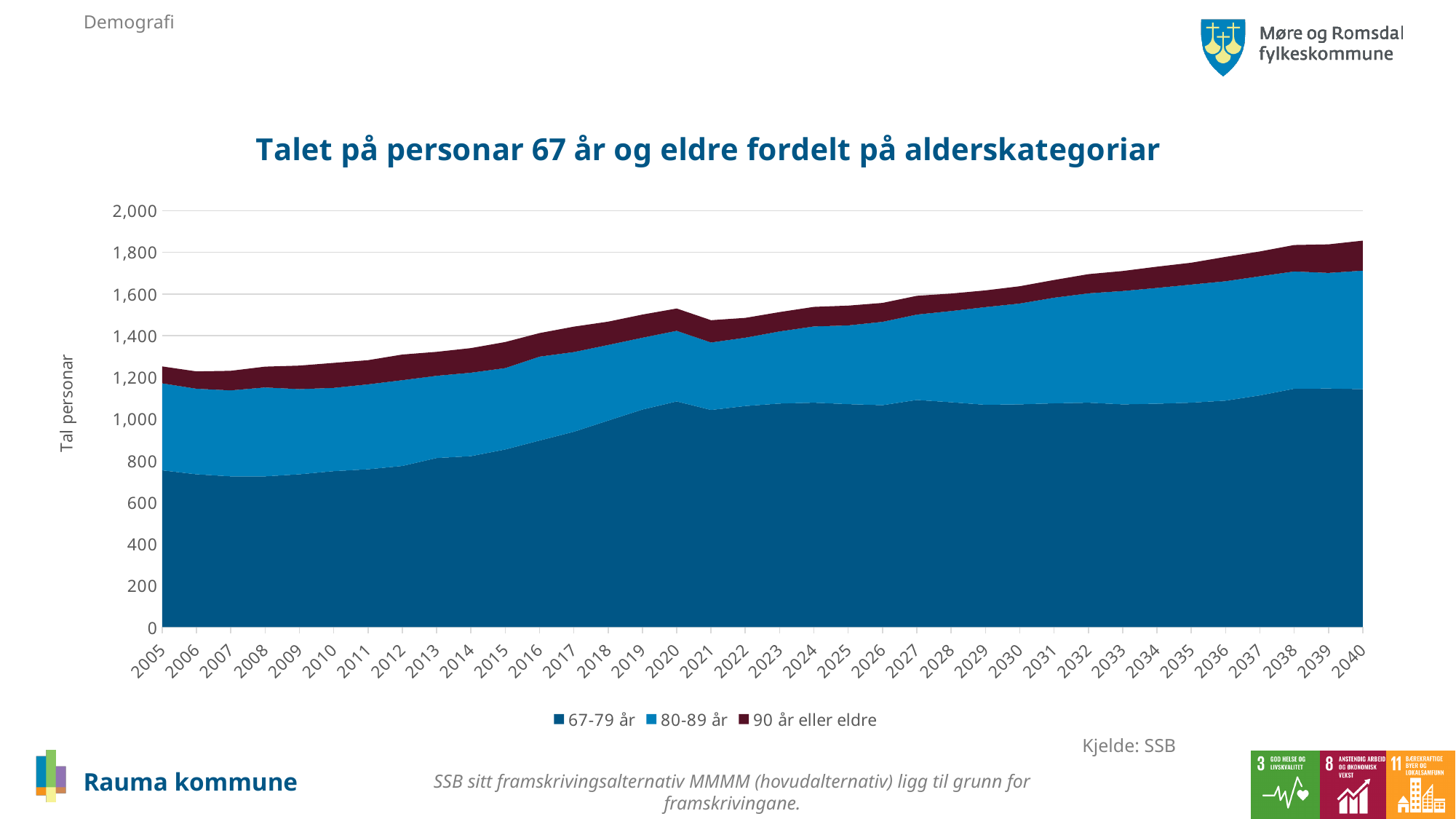
What kind of chart is shown on the slide? Stacked area chart How many series does the legend list? 3 What is the label on the y axis? Tal personar How many years are shown along the x axis? 36 Is the total for 2040 greater or less than 1,800? greater What is the title of the chart? Talet på personar 67 år og eldre fordelt på alderskategoriar Which is larger, the value for 67-79 år in 2020 or in 2005? 2020 Is the value for 67-79 år in 2040 greater or less than 1,000? greater Which year has the highest total number of persons 67 years and older? 2040 Does the total number of persons 67 years and older rise or fall from 2005 to 2040? Rise Is the value for 67-79 år in 2005 greater or less than 800? less